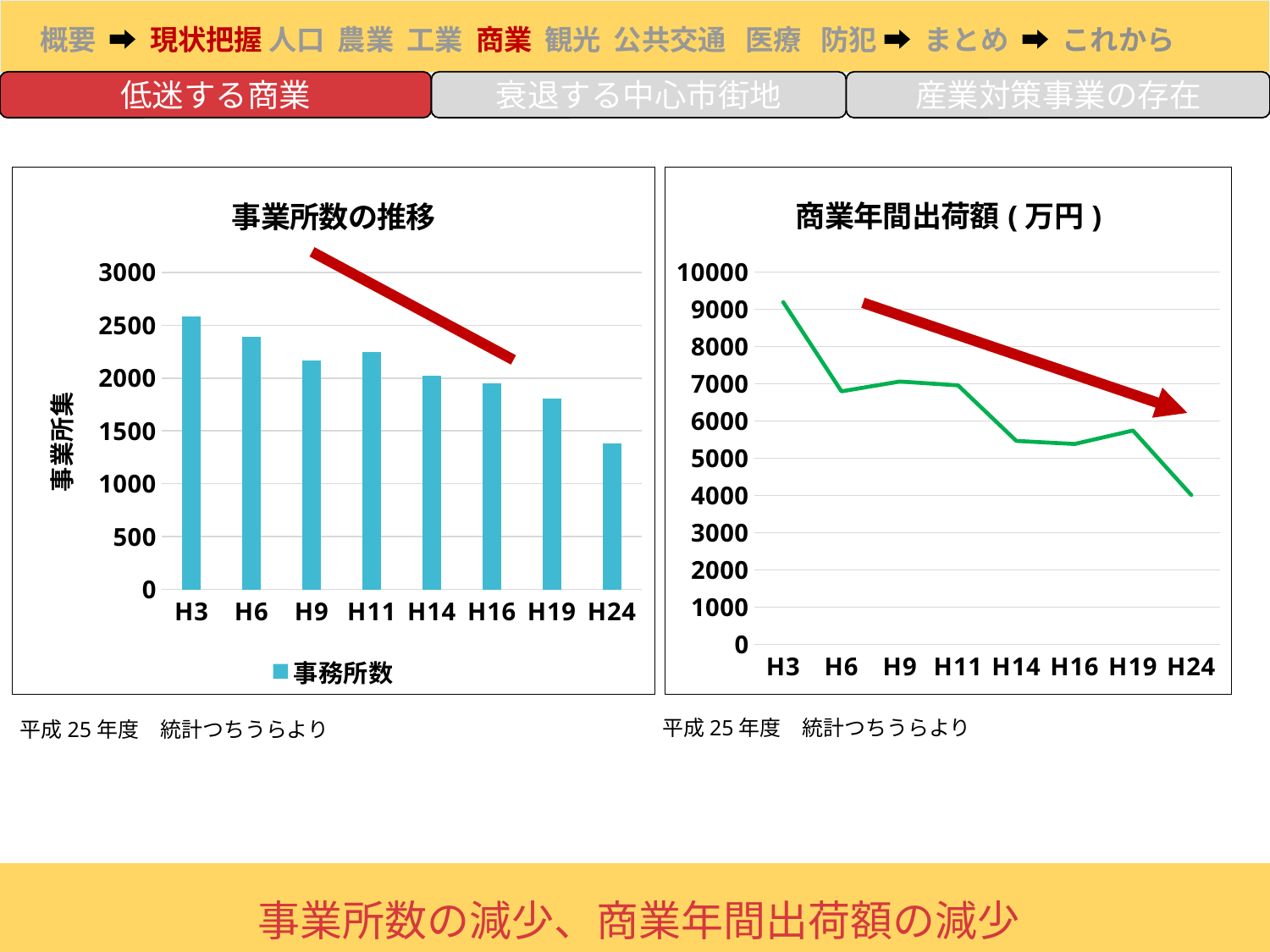
How many series does the legend of the left chart 事業所数の推移 list? 1 What kind of chart is the left chart titled 事業所数の推移? bar chart In the left chart 事業所数の推移, is the value for H24 greater or less than 1500? less In the right chart 商業年間出荷額(万円), which year has the highest value? H3 In the left chart 事業所数の推移, which year has the highest number of establishments? H3 In the left chart 事業所数の推移, is the value for H3 greater or less than 2500? greater In the left chart 事業所数の推移, which year has the lowest number of establishments? H24 What kind of chart is the right chart titled 商業年間出荷額(万円)? line chart In the right chart 商業年間出荷額(万円), do the values generally rise or fall from H3 to H24? fall In the right chart 商業年間出荷額(万円), which is larger, the value for H9 or the value for H14? H9 How many years are shown on the x axis of the left chart 事業所数の推移? 8 In the right chart 商業年間出荷額(万円), is the value for H24 greater or less than 5000? less